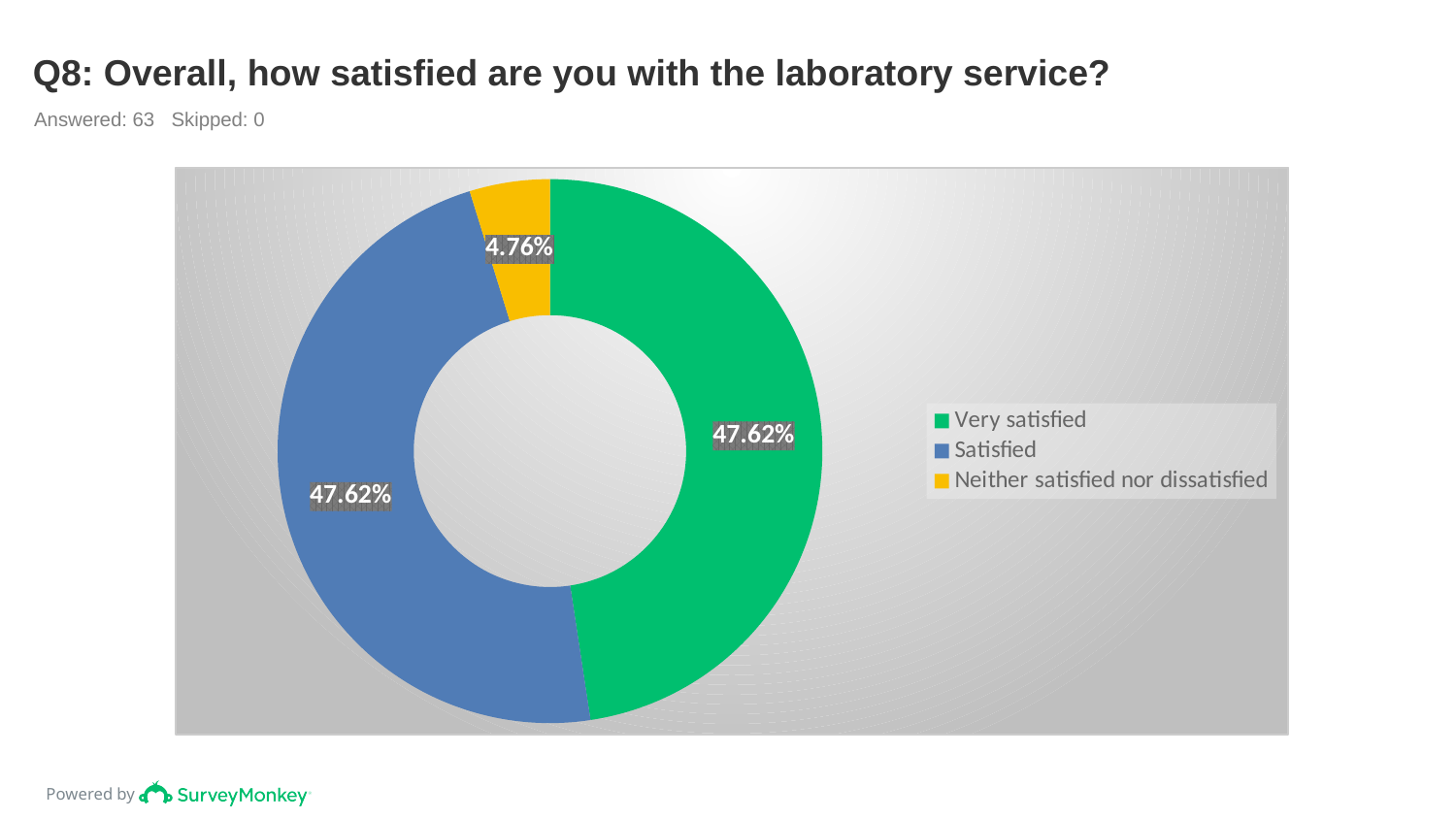
How many respondents answered this question according to the slide? 63 What percentage of respondents answered "Neither satisfied nor dissatisfied"? 4.76% What is the title of the chart on the slide? Q8: Overall, how satisfied are you with the laboratory service? What percentage of respondents answered "Very satisfied"? 47.62% How many entries does the legend list? 3 What is the difference in percentage points between the "Very satisfied" share and the "Neither satisfied nor dissatisfied" share? 42.86% Which is larger: the share for "Satisfied" or the share for "Neither satisfied nor dissatisfied"? Satisfied What percentage of respondents answered "Satisfied"? 47.62% How many response categories are shown in the chart? 3 Which response category has the smallest share of the chart? Neither satisfied nor dissatisfied Which colour represents "Neither satisfied nor dissatisfied" in the chart? Yellow What kind of chart is shown on the slide? Pie (donut) chart